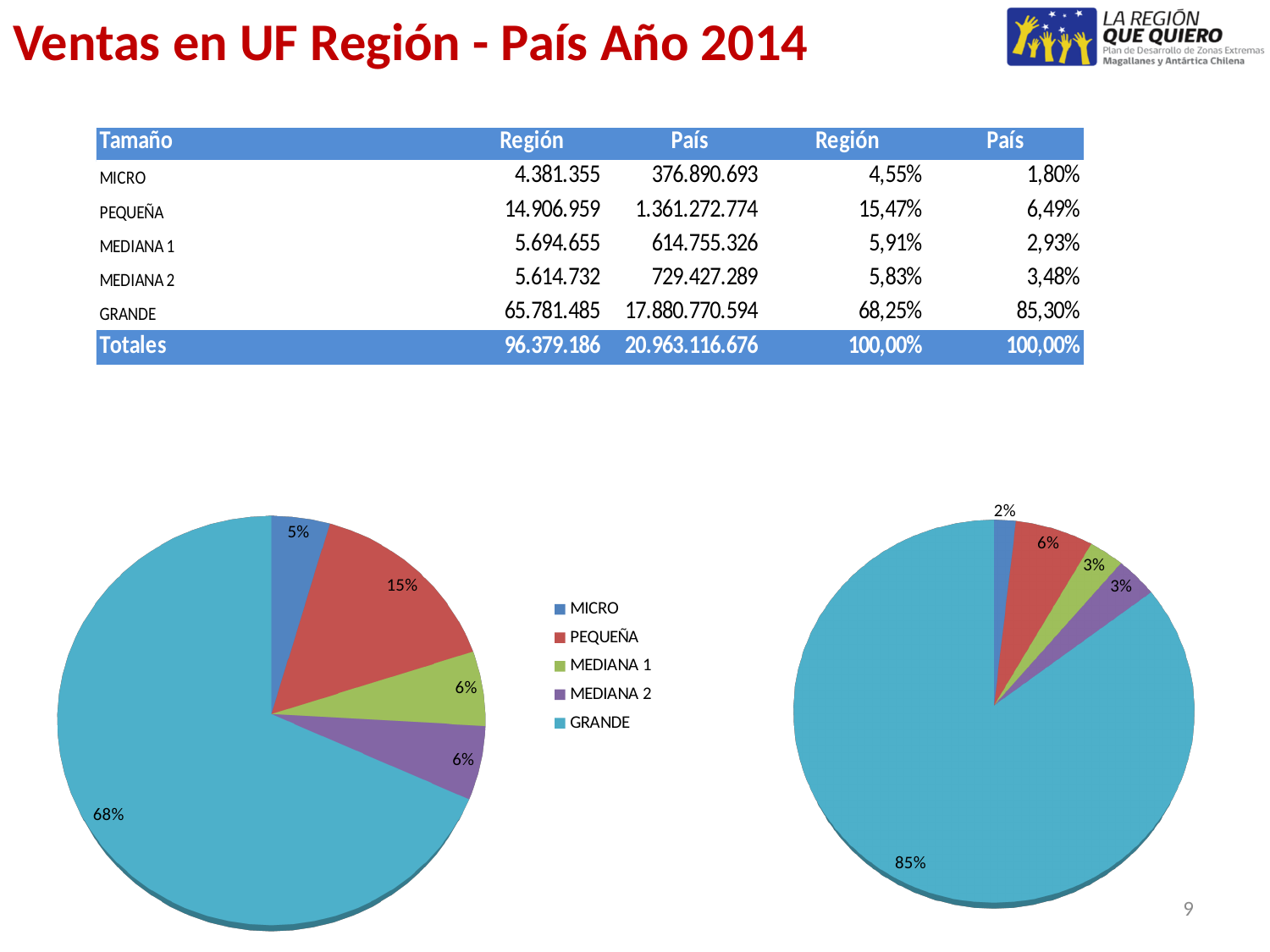
In the right pie chart, what is the difference between the GRANDE share and the PEQUEÑA share? 79 percentage points In the right pie chart, what share does MICRO have? 2% In the left pie chart, which category has the largest slice? GRANDE In the left pie chart, what share does GRANDE have? 68% In the right pie chart, which category has the smallest slice? MICRO How many slices does the right pie chart have? 5 How many entries does the legend between the two pie charts list? 5 In the right pie chart, what share does GRANDE have? 85% In the left pie chart, which category has the smallest slice? MICRO In the left pie chart, which is larger, the PEQUEÑA slice or the MEDIANA 1 slice? PEQUEÑA What kind of chart is the left chart on the slide? Pie chart